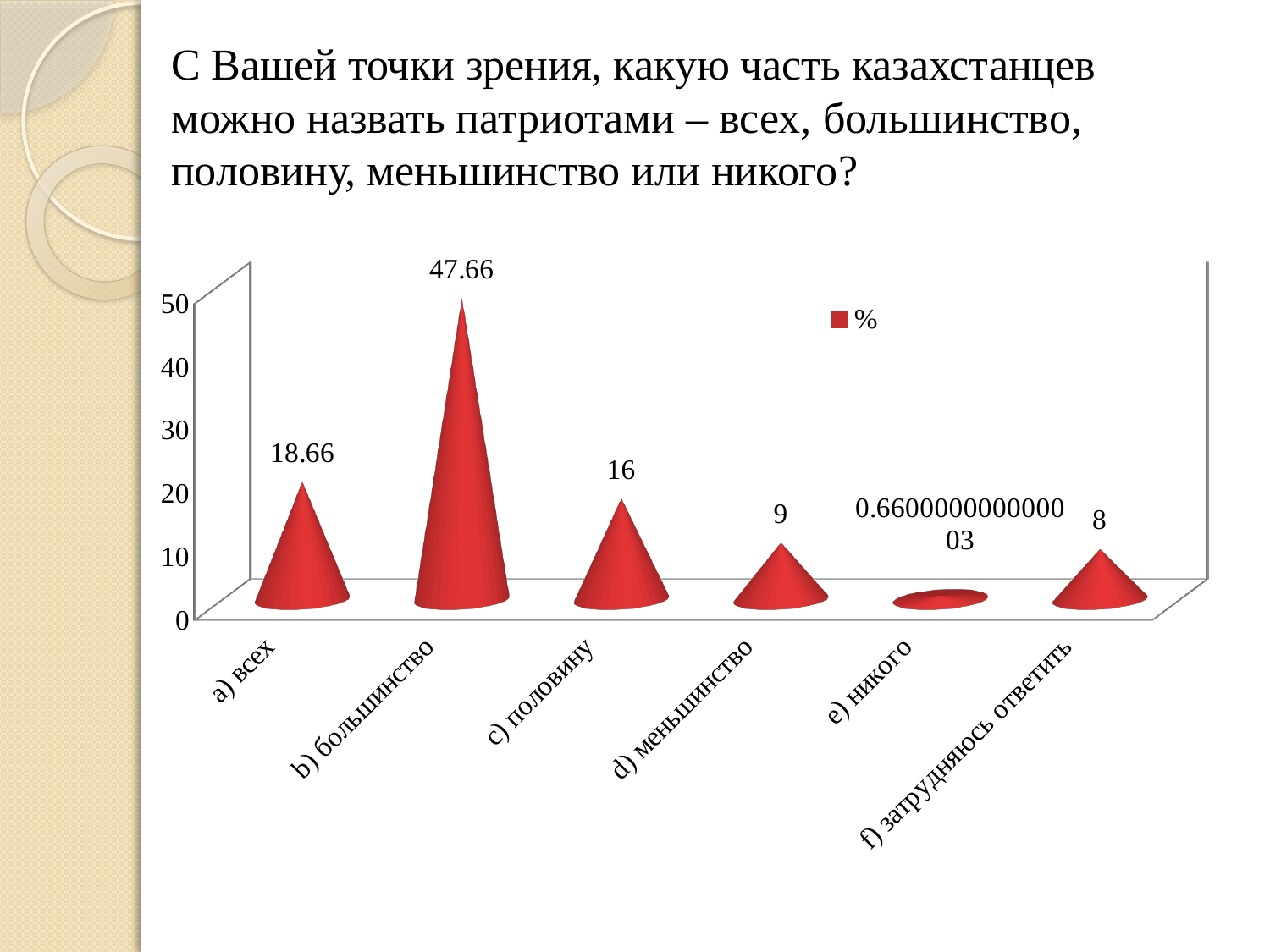
What is the difference between the values for c) половину and d) меньшинство? 7 Which category has the lowest value? e) никого How many series does the legend list? 1 What kind of chart is shown on the slide? bar chart Which is larger, the value for d) меньшинство or f) затрудняюсь ответить? d) меньшинство What value is shown for c) половину? 16 How many categories are shown on the x axis? 6 What value is shown for a) всех? 18.66 What is the difference between the values for b) большинство and a) всех? 29 What value is shown for f) затрудняюсь ответить? 8 Which category has the highest value? b) большинство What value is shown for b) большинство? 47.66